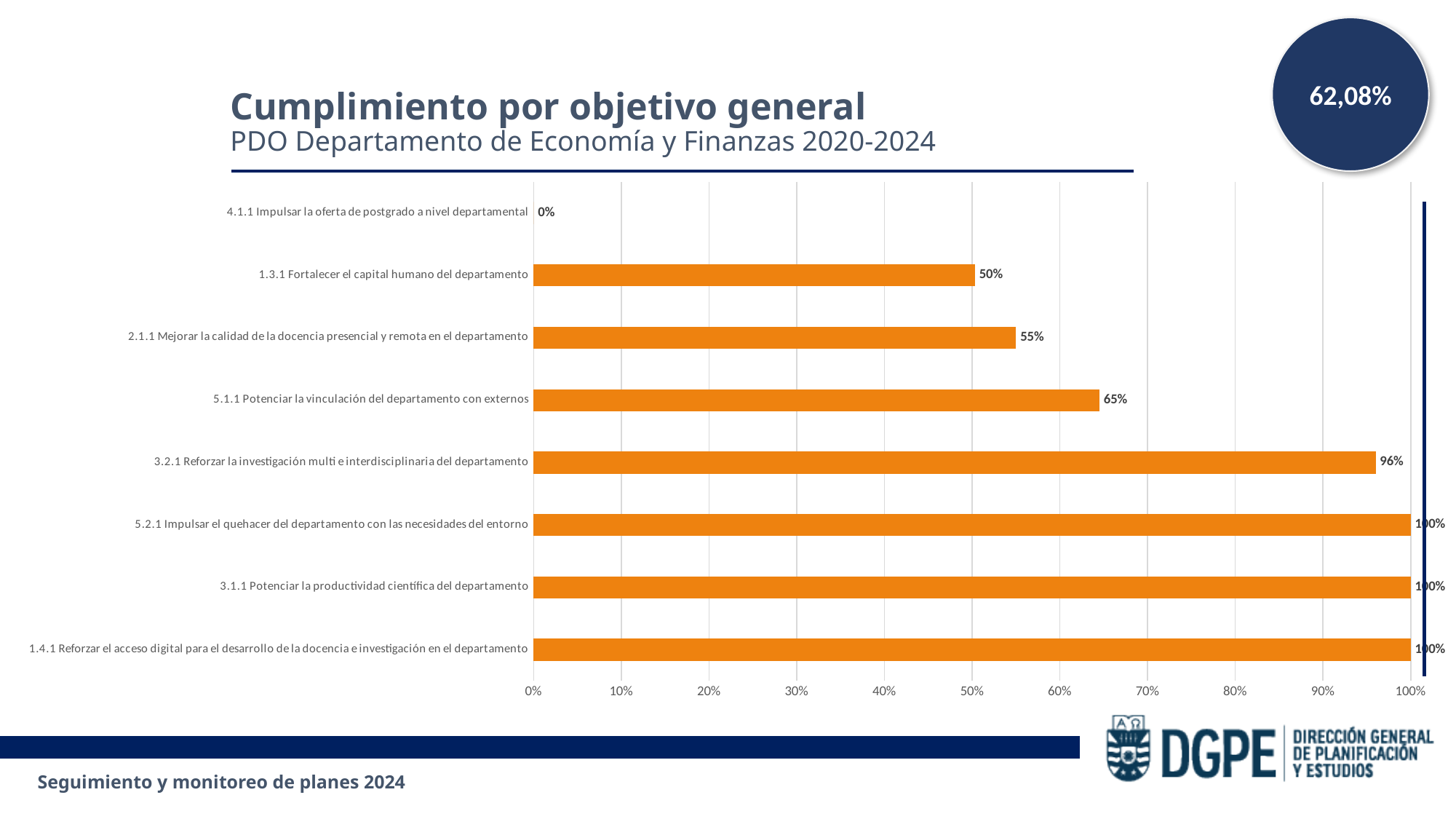
Which is larger, the value for 5.1.1 Potenciar la vinculación del departamento con externos or the value for 1.3.1 Fortalecer el capital humano del departamento? 5.1.1 Potenciar la vinculación del departamento con externos How many objectives have a value of 100%? 3 What is the difference between the values for 3.2.1 Reforzar la investigación multi e interdisciplinaria del departamento and 2.1.1 Mejorar la calidad de la docencia presencial y remota en el departamento? 41% What is the value for 1.3.1 Fortalecer el capital humano del departamento? 50% Which objective has the lowest value? 4.1.1 Impulsar la oferta de postgrado a nivel departamental What kind of chart is shown on the slide? Bar chart What is the title of the chart? Cumplimiento por objetivo general How many objectives are shown in the chart? 8 What is the value for 5.1.1 Potenciar la vinculación del departamento con externos? 65% What is the value for 3.2.1 Reforzar la investigación multi e interdisciplinaria del departamento? 96% What is the value for 4.1.1 Impulsar la oferta de postgrado a nivel departamental? 0% What overall percentage is shown in the circle at the top right of the slide? 62,08%